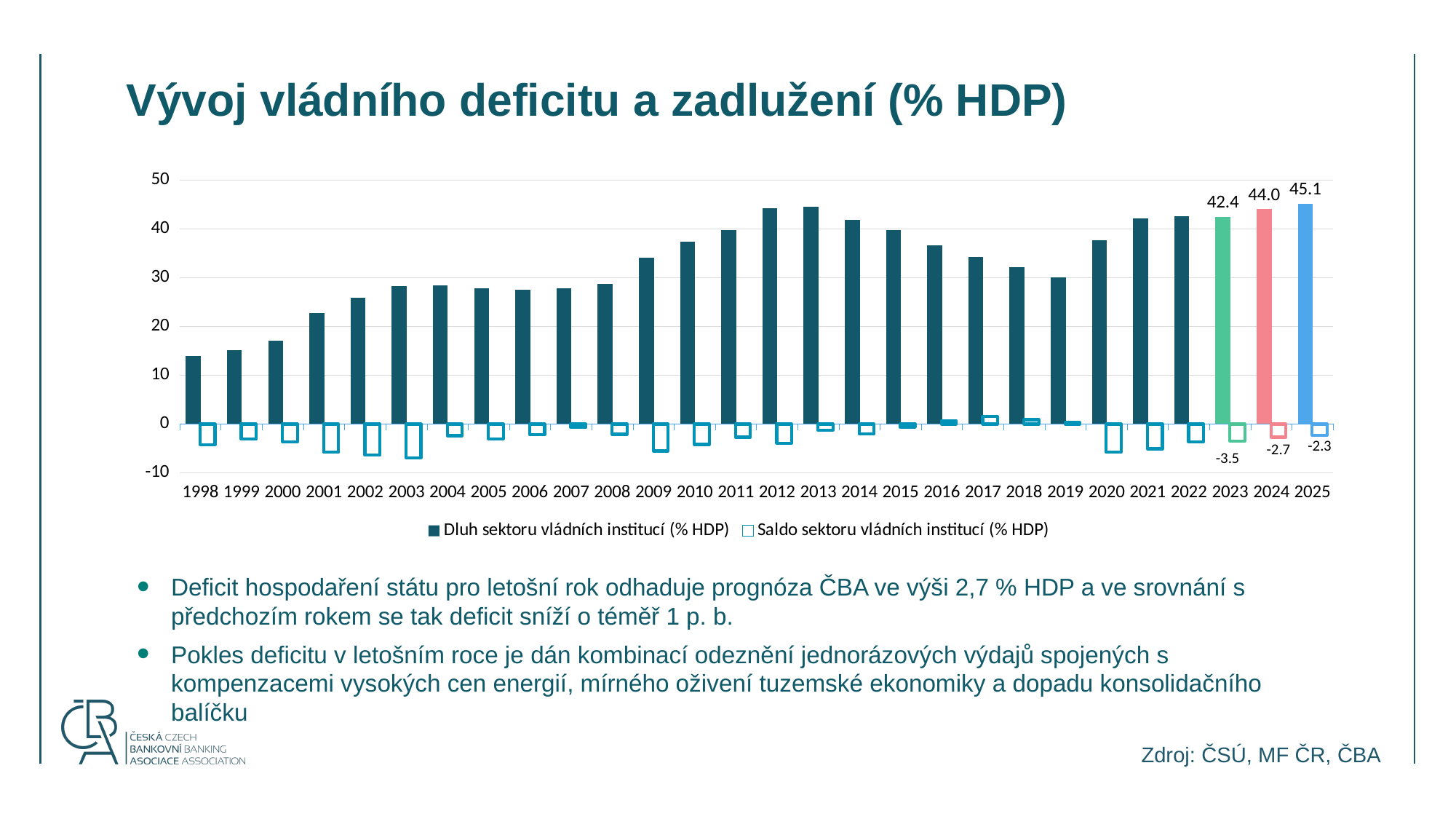
What is the difference between the Saldo sektoru vládních institucí (% HDP) values for 2023 and 2024? 0.8 What is the value of Dluh sektoru vládních institucí (% HDP) for 2023? 42.4 What is the value of Dluh sektoru vládních institucí (% HDP) for 2025? 45.1 Is the value of Dluh sektoru vládních institucí (% HDP) for 2013 greater or less than 40? greater By how much does Dluh sektoru vládních institucí (% HDP) in 2025 exceed the value in 2023? 2.7 Which year has the lowest value of Dluh sektoru vládních institucí (% HDP)? 1998 How many series does the legend list? 2 What is the value of Saldo sektoru vládních institucí (% HDP) for 2024? -2.7 What kind of chart is shown on the slide? Bar chart How many years are shown on the x axis of the chart? 28 Does Dluh sektoru vládních institucí (% HDP) rise or fall from 2023 to 2025? Rises What is the value of Saldo sektoru vládních institucí (% HDP) for 2023? -3.5